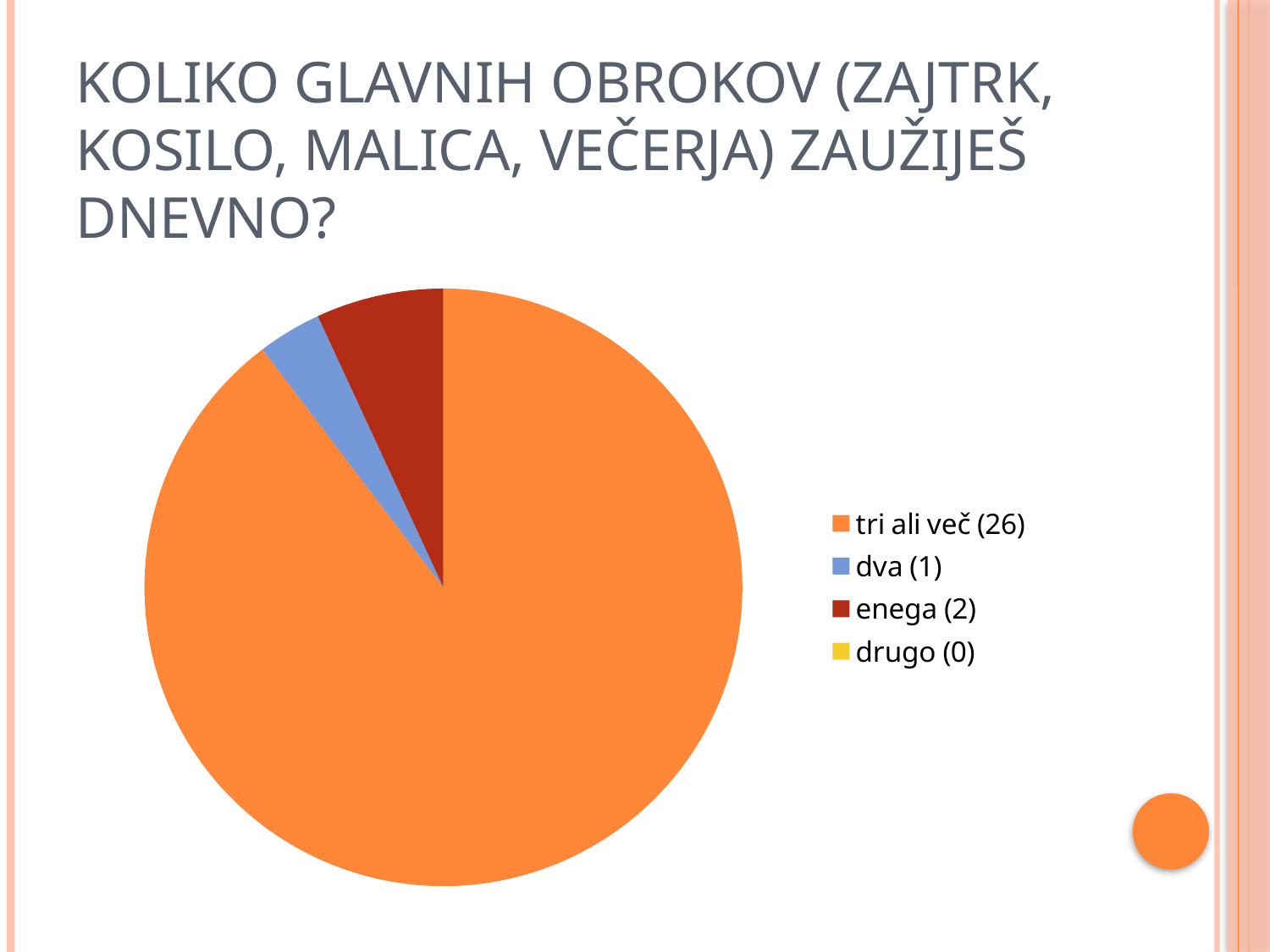
How many respondents answered "drugo"? 0 How many respondents answered "enega"? 2 What kind of chart is shown on the slide? pie chart How many respondents answered "dva"? 1 How many categories does the legend list? 4 What is the difference between the values for "tri ali več" and "enega"? 24 What colour is the slice for "enega"? dark red Which category has the smallest value? drugo Which category has the largest value? tri ali več How many respondents answered "tri ali več"? 26 What is the total of all the values listed in the legend? 29 Which is larger, the value for "enega" or the value for "dva"? enega